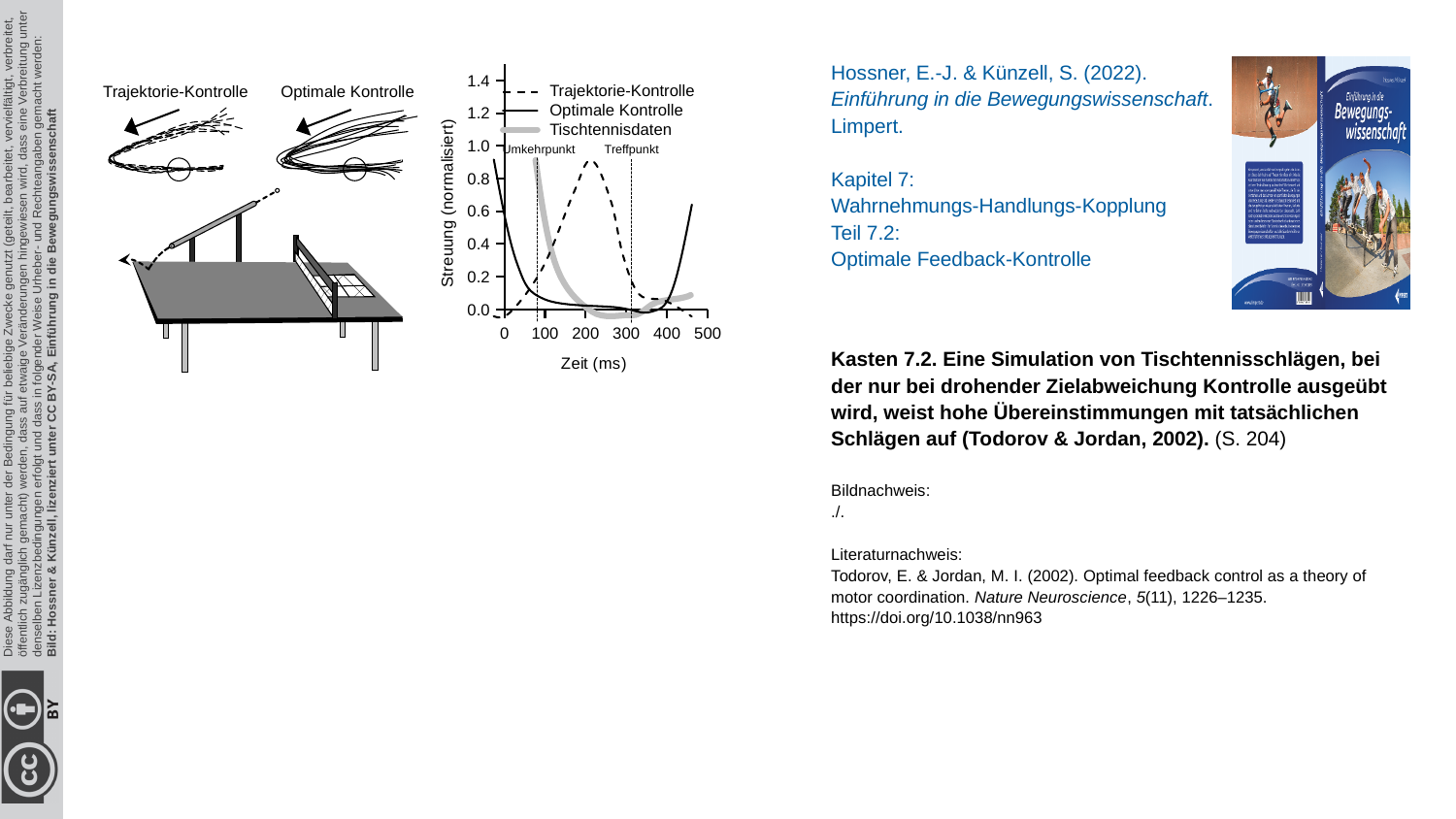
What kind of chart is shown on the slide? line chart At 200 ms, which series has the higher value, Trajektorie-Kontrolle or Optimale Kontrolle? Trajektorie-Kontrolle What is the label of the x axis of the chart? Zeit (ms) Is the value of Trajektorie-Kontrolle at 400 ms greater or less than 0.2? less Does the Optimale Kontrolle curve rise or fall between 0 ms and 200 ms? fall Is the value of Optimale Kontrolle at 500 ms greater or less than 0.4? greater Is the value of Tischtennisdaten at 300 ms greater or less than 0.2? less Does the Trajektorie-Kontrolle curve rise or fall between 0 ms and 200 ms? rise How many series does the chart legend list? 3 What is the label of the y axis of the chart? Streuung (normalisiert)